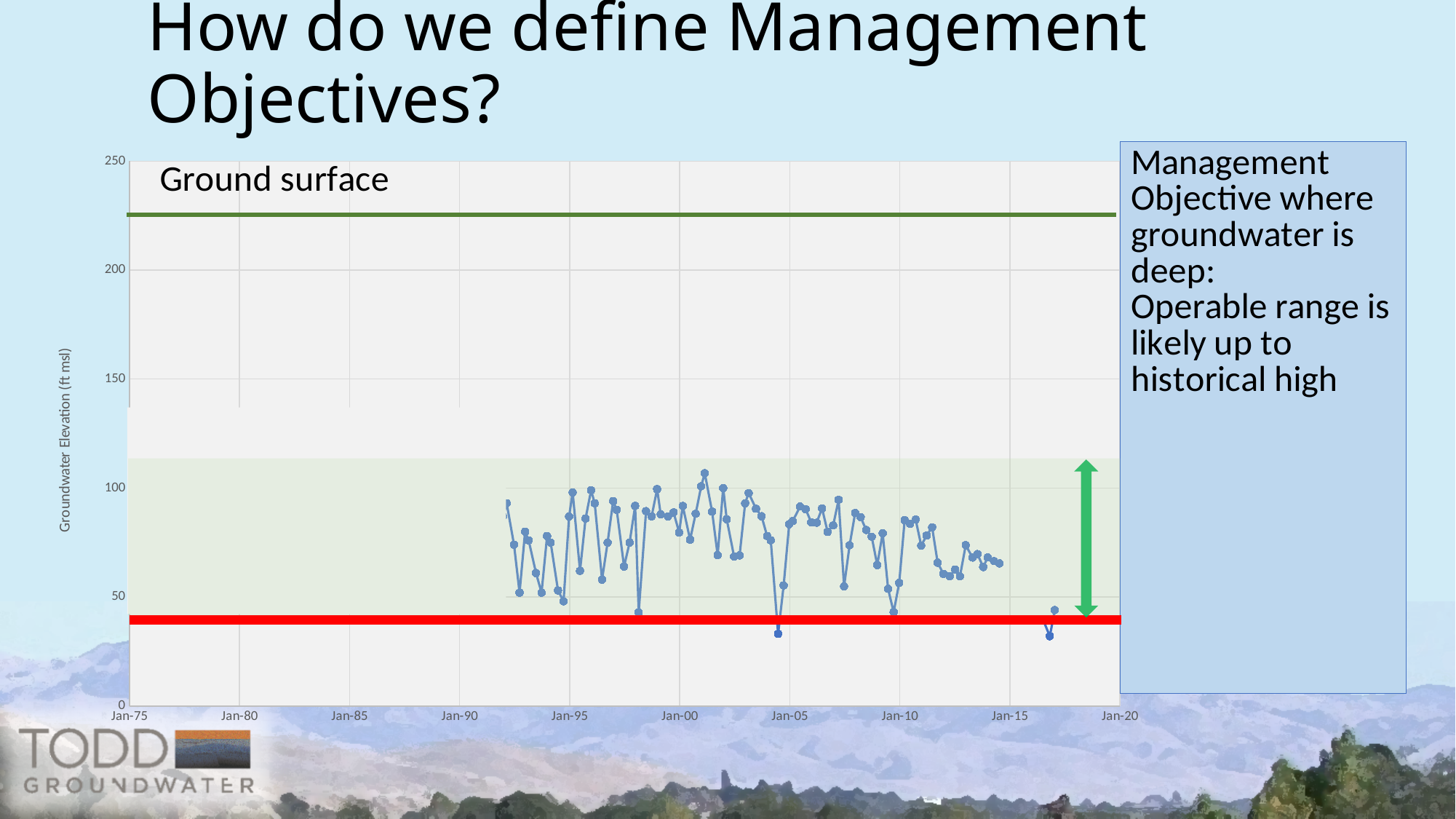
What is the label on the vertical axis of the chart? Groundwater Elevation (ft msl) Is the highest plotted groundwater elevation point greater or less than 150? less How many year labels are shown along the horizontal axis? 10 Is the ground surface line greater or less than 200 on the vertical axis? greater Is the red horizontal line greater or less than 50 on the vertical axis? less Do the plotted groundwater elevation values generally rise or fall between Jan-10 and Jan-15? fall What is the maximum value shown on the vertical axis? 250 What label is written above the dark green horizontal line near the top of the chart? Ground surface What is the first year label on the horizontal axis? Jan-75 What kind of chart is shown on the slide? line chart